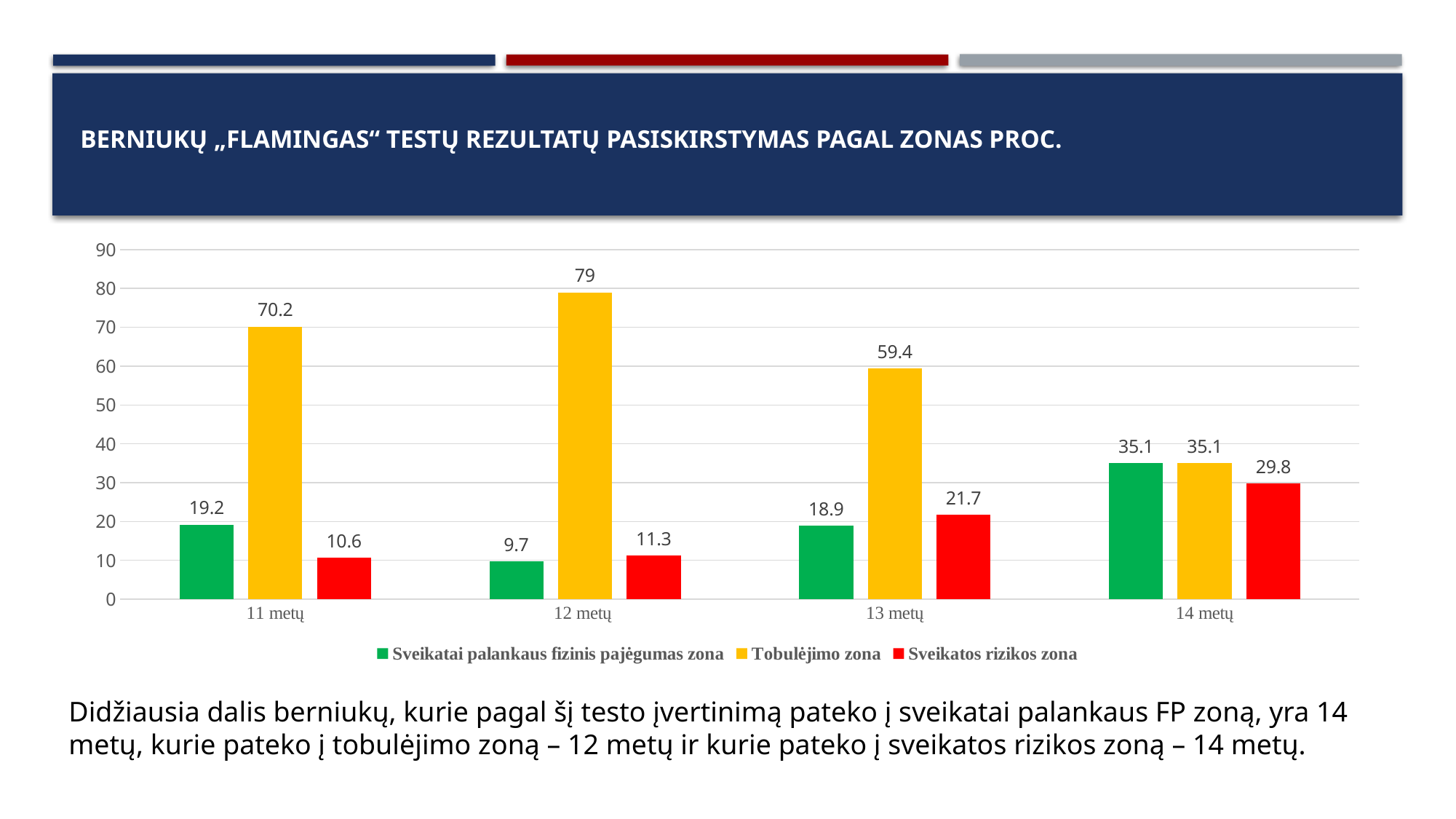
Which age group has the highest value for Tobulėjimo zona? 12 metų How many age groups are shown on the x axis? 4 Which is larger: Sveikatos rizikos zona at 13 metų or Sveikatos rizikos zona at 14 metų? 14 metų What is the value for Tobulėjimo zona at 12 metų? 79 Is the value for Tobulėjimo zona at 13 metų greater or less than 50? greater What is the value for Sveikatos rizikos zona at 11 metų? 10.6 Which age group has the lowest value for Sveikatai palankaus fizinis pajėgumas zona? 12 metų How many series does the legend list? 3 Which colour represents Sveikatos rizikos zona in the legend? red What is the value for Sveikatai palankaus fizinis pajėgumas zona at 13 metų? 18.9 What kind of chart is shown on the slide? bar chart What is the difference between the Tobulėjimo zona values for 11 metų and 13 metų? 10.8